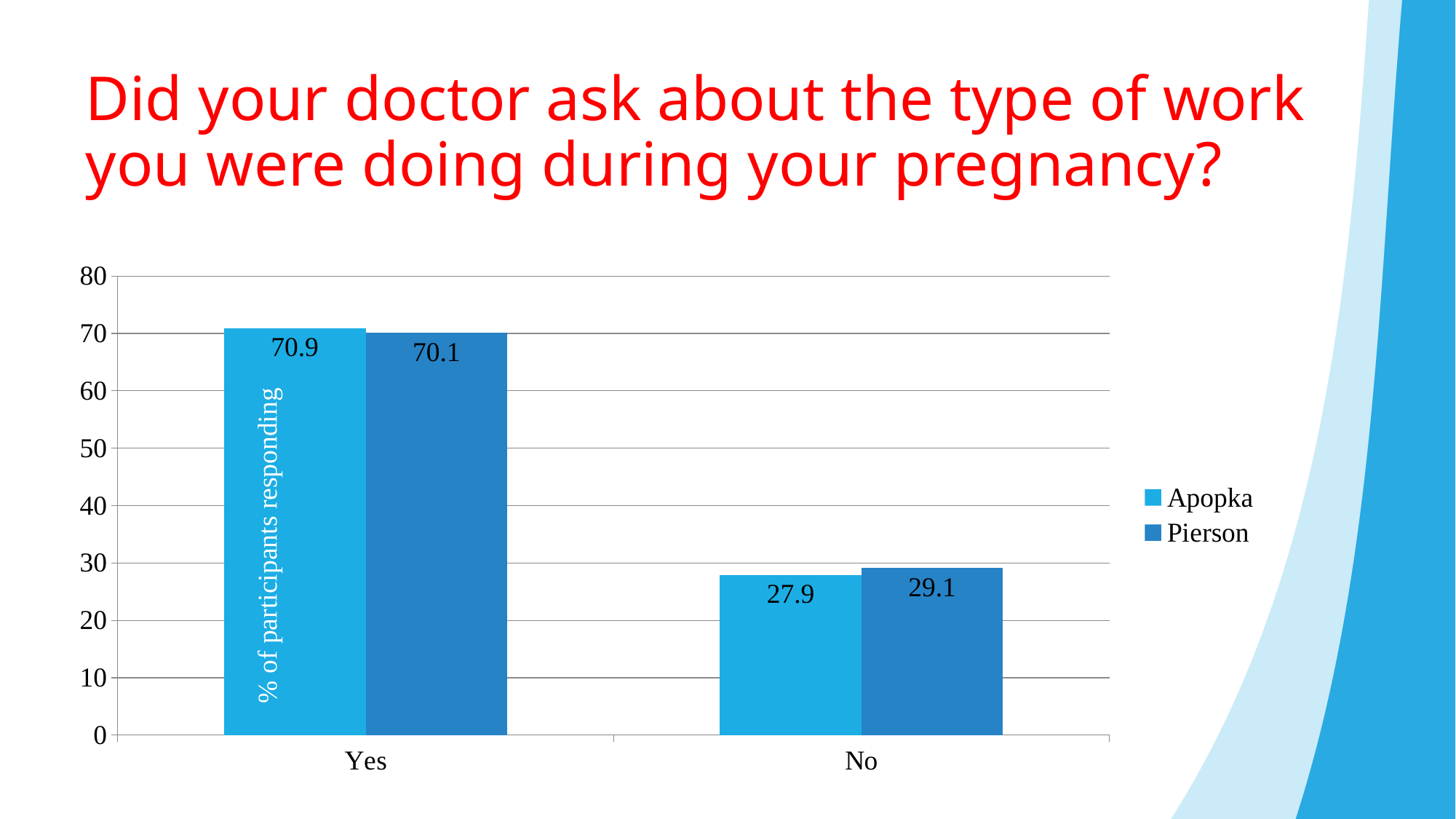
Which category has the lowest value for Pierson? No How many categories are shown on the x axis? 2 How many series does the legend list? 2 What kind of chart is shown on the slide? bar chart What is the value for Pierson in the Yes category? 70.1 Is the Apopka value for Yes greater or less than the Apopka value for No? greater What is the value for Apopka in the No category? 27.9 What is the difference between the Pierson and Apopka values in the No category? 1.2 What is the value for Apopka in the Yes category? 70.9 What is the difference between the Apopka and Pierson values in the Yes category? 0.8 What is the value for Pierson in the No category? 29.1 Which category has the highest value for Apopka? Yes